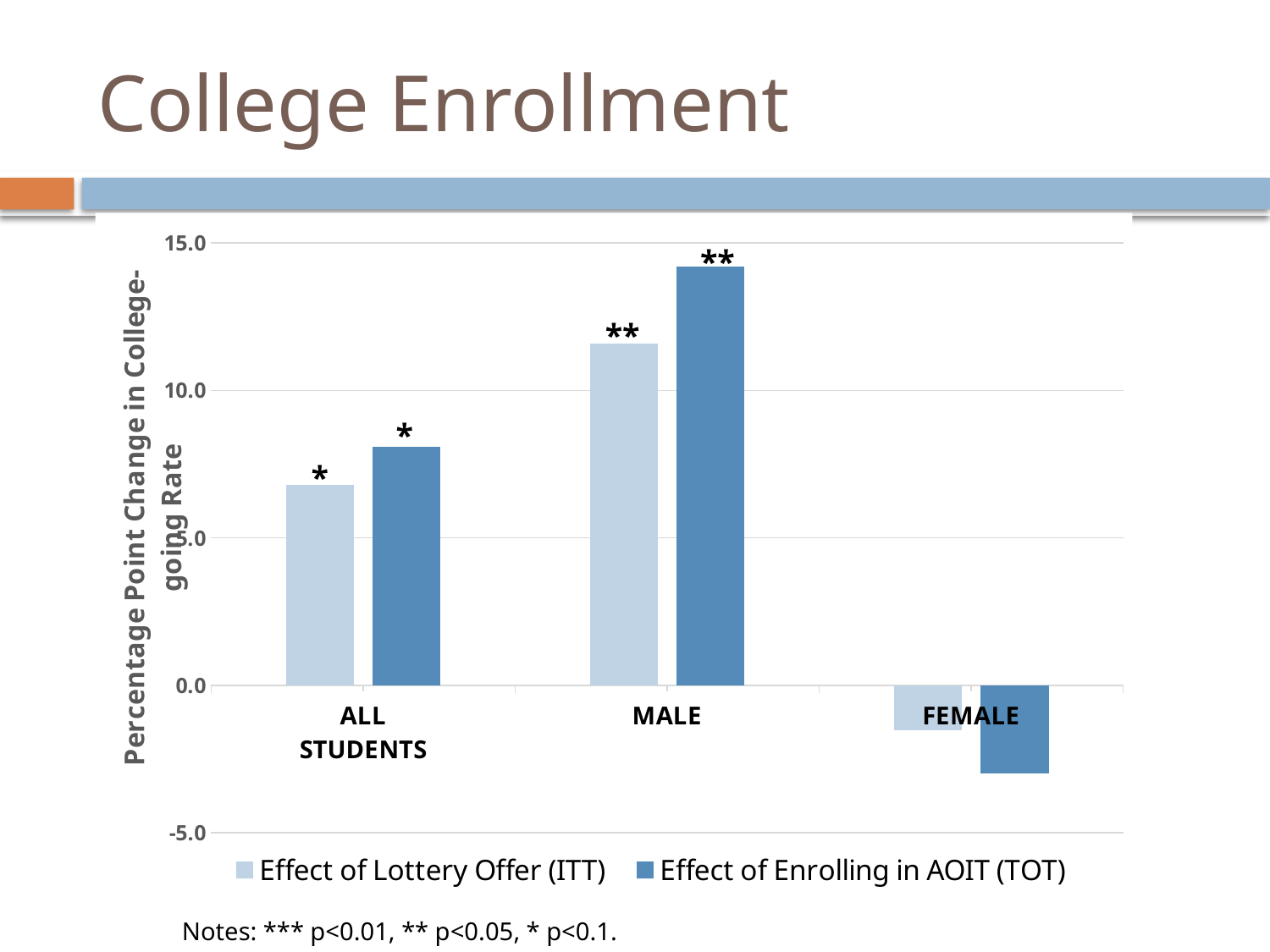
How many series does the chart's legend list? 2 How many categories are shown on the x axis of the chart? 3 Is the Effect of Lottery Offer (ITT) value for All Students greater or less than 10.0? less For Male, which is larger: Effect of Lottery Offer (ITT) or Effect of Enrolling in AOIT (TOT)? Effect of Enrolling in AOIT (TOT) Is the Effect of Enrolling in AOIT (TOT) value for Female greater or less than 0.0? less What is the label on the chart's vertical axis? Percentage Point Change in College-going Rate What kind of chart is shown on the slide? bar chart Is the Effect of Enrolling in AOIT (TOT) value for Male greater or less than 10.0? greater Which category has the lowest value for Effect of Lottery Offer (ITT)? Female What is the title of the slide containing the chart? College Enrollment Which category has the lowest value for Effect of Enrolling in AOIT (TOT)? Female Which category has the highest value for Effect of Enrolling in AOIT (TOT)? Male